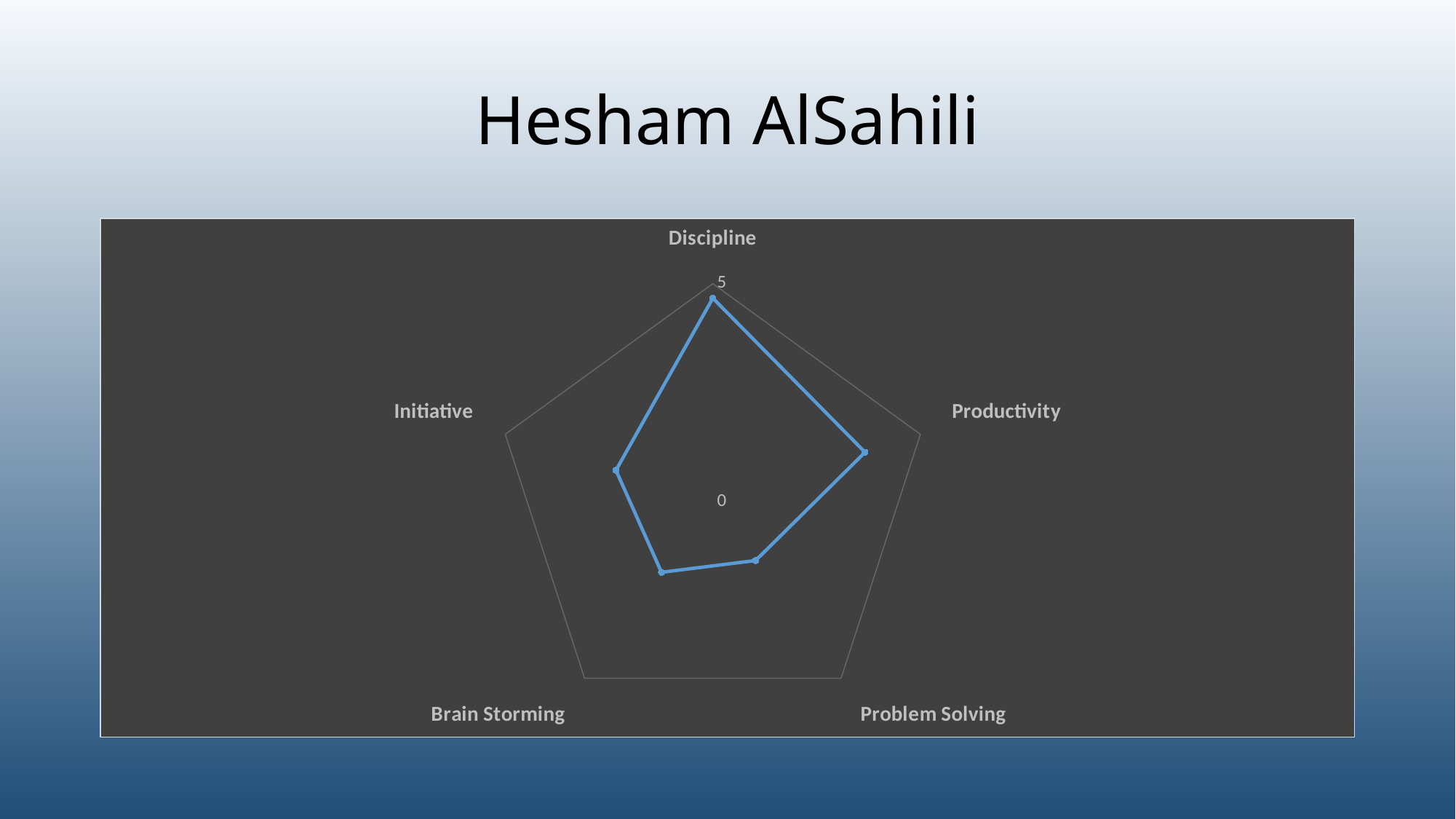
Which category has the highest value on the radar chart? Discipline Which is larger, the value for Productivity or the value for Initiative? Productivity How many categories (axes) does the radar chart have? 5 What kind of chart is shown on the slide? Radar chart Which is larger, the value for Productivity or the value for Brain Storming? Productivity What is the maximum value shown on the radar chart's axis? 5 Which is larger, the value for Discipline or the value for Problem Solving? Discipline What is the title of the slide containing the radar chart? Hesham AlSahili